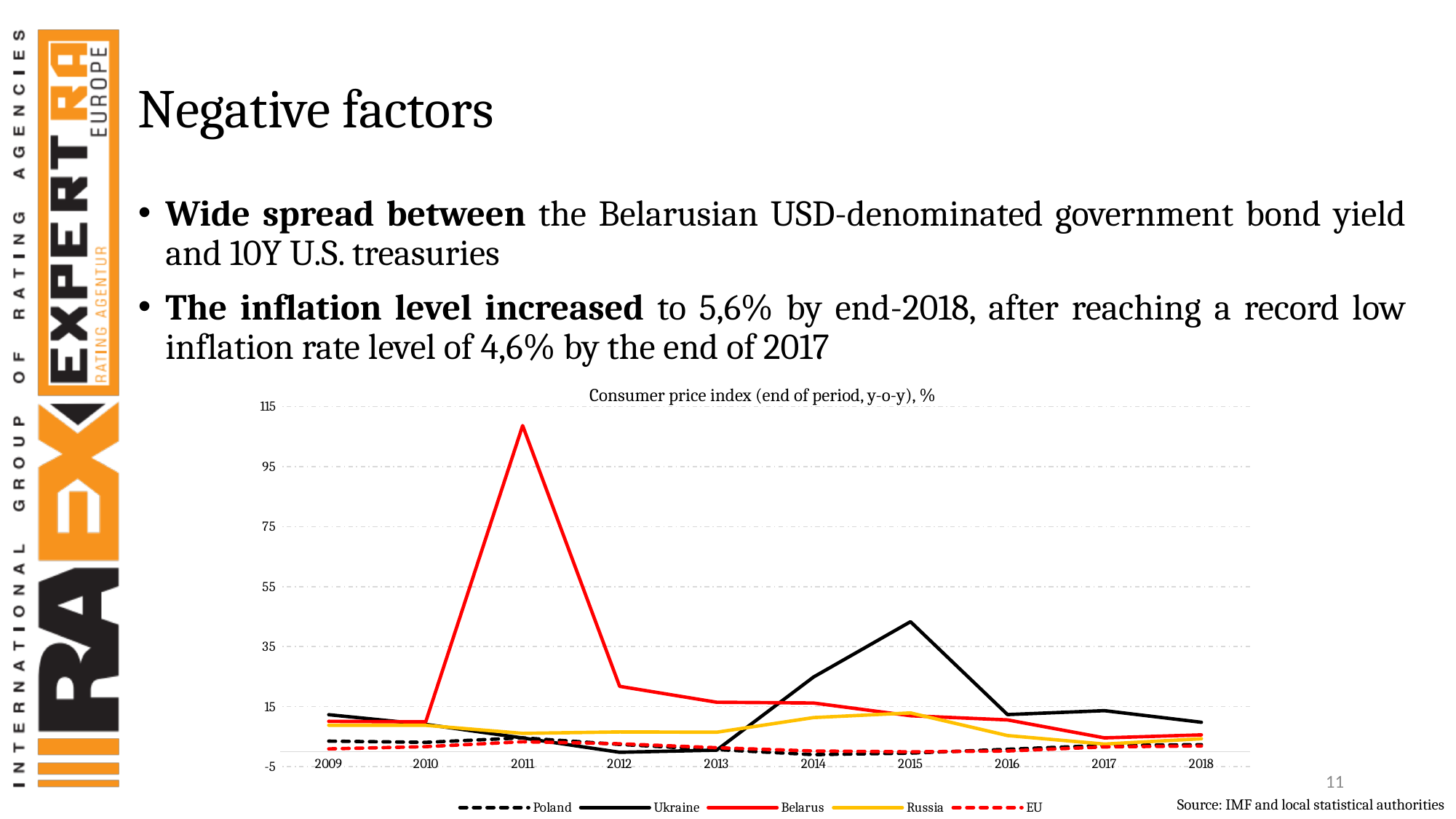
Is the value for Russia in 2015 greater or less than 15? less In 2015, which is higher: Ukraine or Belarus? Ukraine How many years are shown along the x axis of the chart? 10 Is the value for Belarus in 2011 greater or less than 95? greater In which year does the Ukraine line reach its peak? 2015 What is the title of the chart? Consumer price index (end of period, y-o-y), % How many series does the legend of the chart list? 5 What kind of chart is shown on the slide? Line chart Does the Belarus line rise or fall from 2011 to 2013? Fall Which country's line reaches the highest value on the chart? Belarus Is the value for Ukraine in 2015 greater or less than 35? greater In which year does the Belarus line reach its peak? 2011